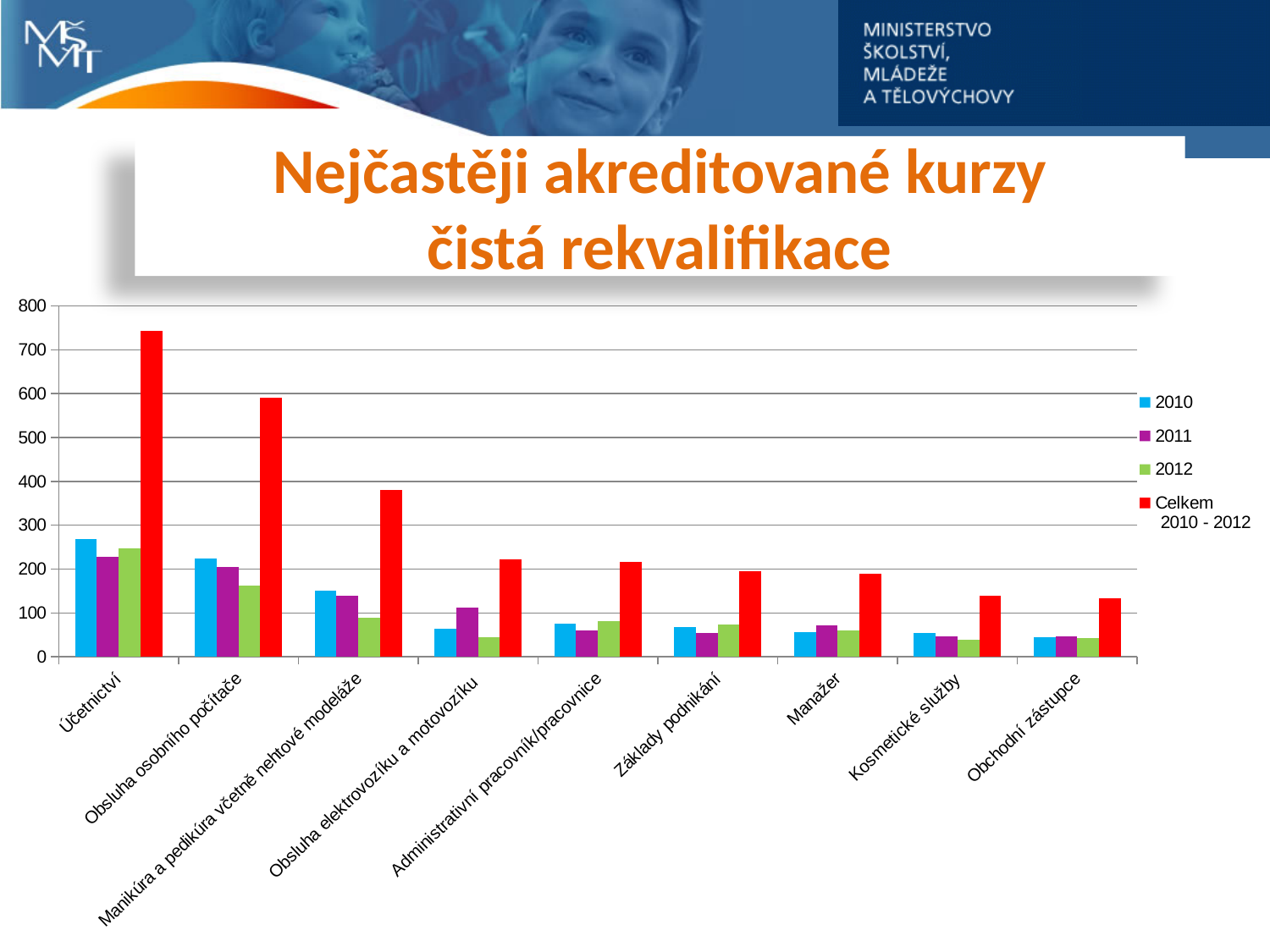
How many series does the chart legend list? 4 Is the Celkem 2010 - 2012 value for Obsluha osobního počítače greater or less than 500? greater Which category has the highest value for the series Celkem 2010 - 2012? Účetnictví Is the Celkem 2010 - 2012 value for Manikúra a pedikúra včetně nehtové modeláže greater or less than 400? less Is the Celkem 2010 - 2012 value for Účetnictví greater or less than 700? greater What kind of chart is shown on the slide? bar chart How many course categories are shown on the x axis of the chart? 9 For Účetnictví, which series has the larger value, 2010 or 2012? 2010 Do the Celkem 2010 - 2012 values rise or fall moving from left to right along the x axis? fall For Obsluha elektrovozíku a motovozíku, which series has the larger value, 2010 or 2011? 2011 What colour represents the series Celkem 2010 - 2012 in the chart? red